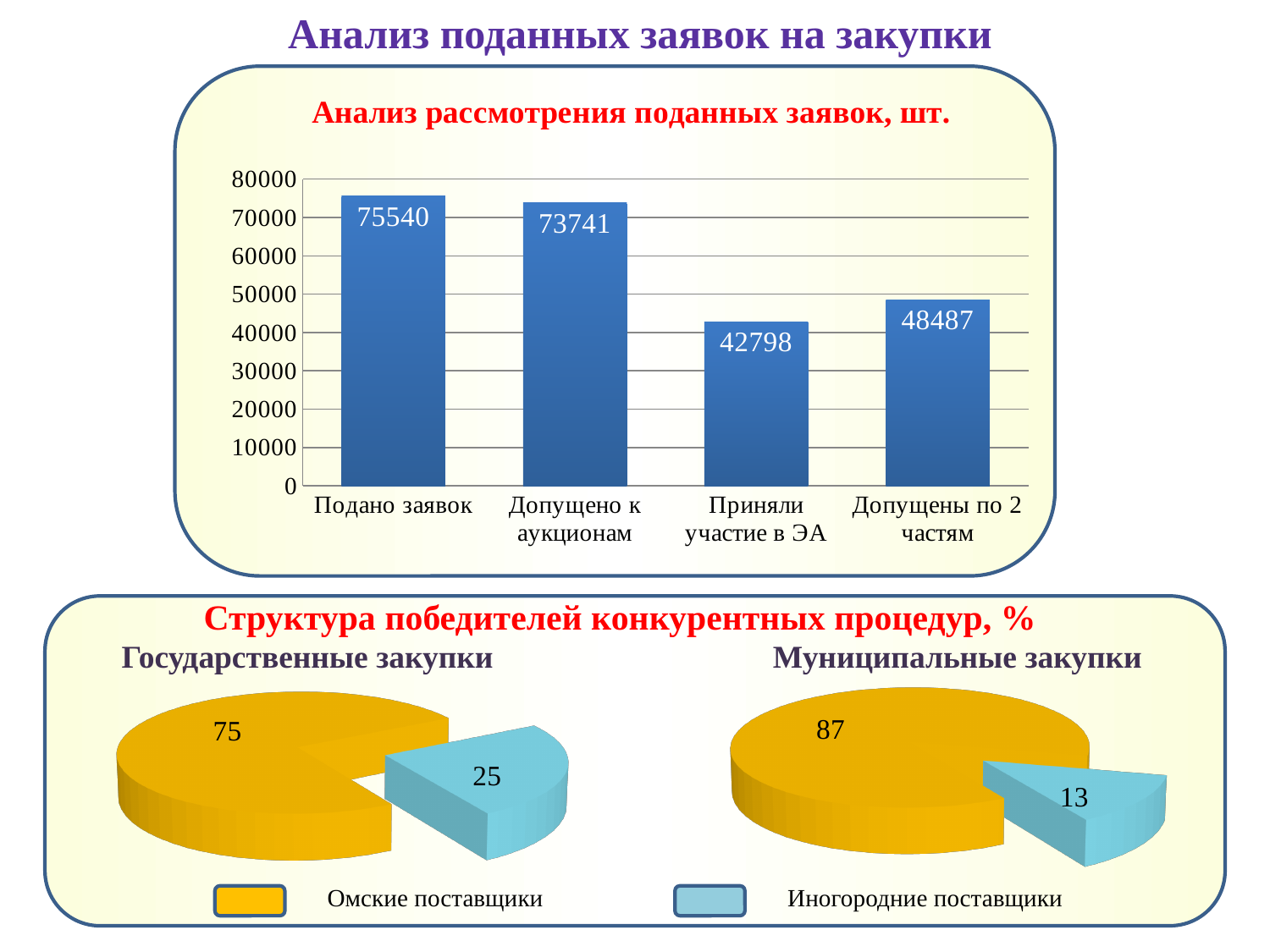
In the pie chart 'Муниципальные закупки', what is the difference between the shares of 'Омские поставщики' and 'Иногородние поставщики'? 74 In the chart 'Анализ рассмотрения поданных заявок, шт.', what is the difference between 'Подано заявок' and 'Допущено к аукционам'? 1799 In the chart 'Анализ рассмотрения поданных заявок, шт.', which category has the lowest value? Приняли участие в ЭА In the pie chart 'Государственные закупки', what share do 'Омские поставщики' have? 75 In the chart 'Анализ рассмотрения поданных заявок, шт.', what is the value for 'Приняли участие в ЭА'? 42798 In the pie chart 'Муниципальные закупки', what share do 'Иногородние поставщики' have? 13 In the chart 'Анализ рассмотрения поданных заявок, шт.', what is the value for 'Подано заявок'? 75540 What type of chart is 'Анализ рассмотрения поданных заявок, шт.'? bar chart In the chart 'Анализ рассмотрения поданных заявок, шт.', which is larger: 'Допущены по 2 частям' or 'Приняли участие в ЭА'? Допущены по 2 частям How many categories are shown in the chart 'Анализ рассмотрения поданных заявок, шт.'? 4 How many entries does the legend under the pie charts 'Структура победителей конкурентных процедур, %' list? 2 In the chart 'Анализ рассмотрения поданных заявок, шт.', which category has the highest value? Подано заявок